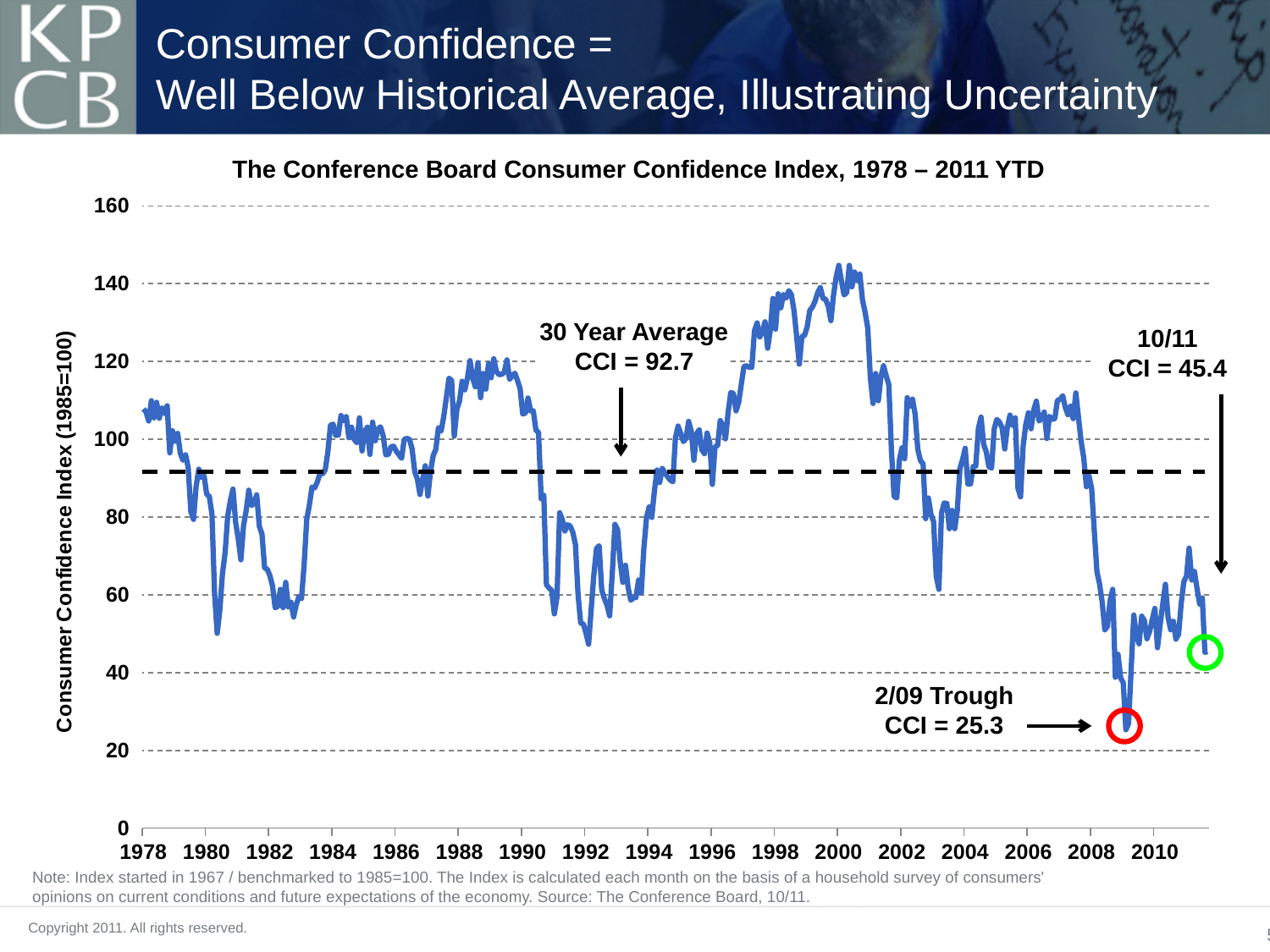
Is the value of the index at the 2/09 trough greater or less than 40? less What does the horizontal dashed black line across the chart represent? 30 Year Average CCI = 92.7 Is the peak value of the index around 2000 greater or less than 120? greater How much higher is the 10/11 CCI (45.4) than the 2/09 trough (25.3)? 20.1 What CCI value is given for the 2/09 trough? 25.3 What is the label on the vertical axis of the chart? Consumer Confidence Index (1985=100) What kind of chart is shown on the slide? line chart Did the index rise or fall between 2008 and early 2009? fall How far below the 30 Year Average (92.7) is the 10/11 CCI (45.4)? 47.3 What was the Consumer Confidence Index value in 10/11 according to the annotation? 45.4 Which is larger, the 10/11 CCI or the 2/09 trough CCI? 10/11 CCI What is the 30 Year Average CCI shown on the chart? 92.7